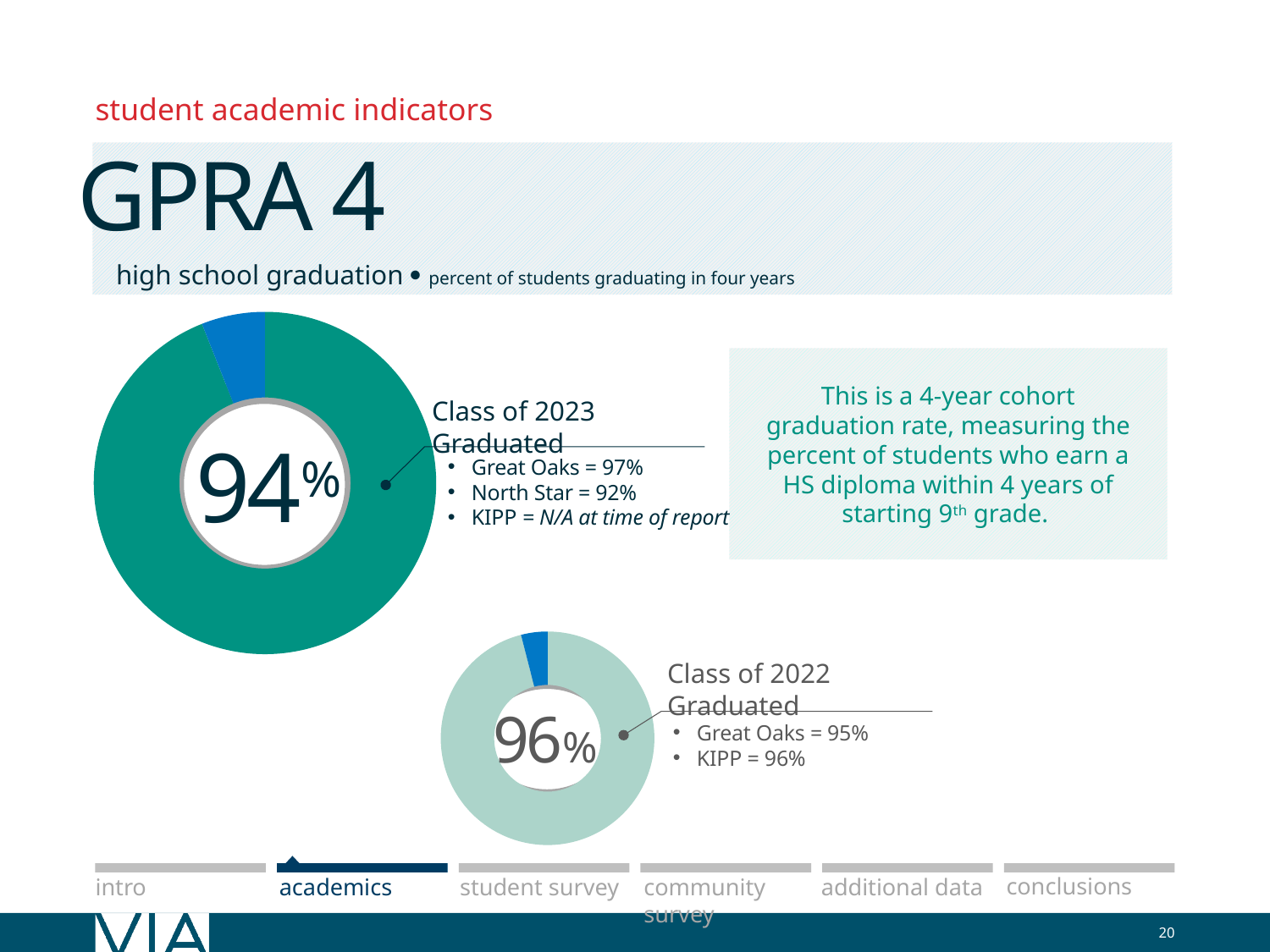
According to the Class of 2022 Graduated breakdown, what was KIPP's graduation rate? 96% What colour is the small slice in the Class of 2023 Graduated donut chart? Blue What type of chart is used to show the graduation rates on this slide? Pie (donut) chart According to the Class of 2023 Graduated breakdown, what was Great Oaks' graduation rate? 97% What is the difference between the Class of 2022 graduation rate (96%) and the Class of 2023 graduation rate (94%)? 2 percentage points Which class has the higher overall graduation rate, Class of 2023 or Class of 2022? Class of 2022 In the Class of 2023 Graduated chart, what share of the pie does the large green slice represent? 94% In the Class of 2023 Graduated donut chart, what percentage is shown in the centre? 94% For the Class of 2023, which school had the higher graduation rate, Great Oaks or North Star? Great Oaks In the Class of 2022 Graduated donut chart, what percentage is shown in the centre? 96% According to the Class of 2023 Graduated breakdown, what was North Star's graduation rate? 92% How many donut charts are shown on the slide? 2